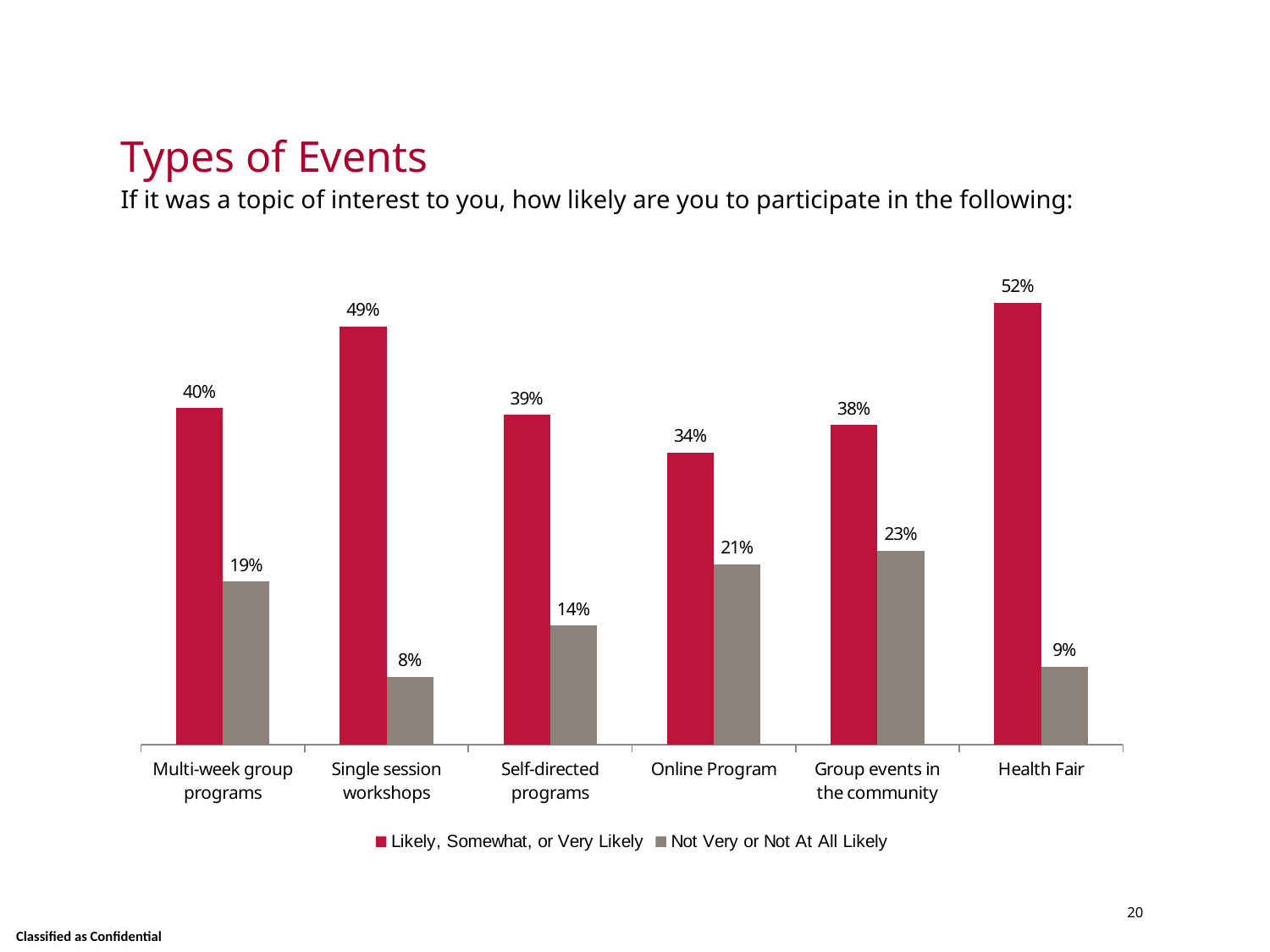
Which event type has the highest Likely, Somewhat, or Very Likely percentage? Health Fair Which event type has the highest Not Very or Not At All Likely percentage? Group events in the community Which event type has the lowest Likely, Somewhat, or Very Likely percentage? Online Program What is the Likely, Somewhat, or Very Likely value for Online Program? 34% What percentage of respondents are Likely, Somewhat, or Very Likely to participate in a Health Fair? 52% How many event types are shown on the x axis? 6 What is the Not Very or Not At All Likely value for Single session workshops? 8% What kind of chart is shown on the slide? Bar chart What is the difference between the Likely, Somewhat, or Very Likely and Not Very or Not At All Likely values for Multi-week group programs? 21% Which is larger: the Likely, Somewhat, or Very Likely value for Single session workshops or for Self-directed programs? Single session workshops How many series does the legend list? 2 What colour represents the Not Very or Not At All Likely series? Grey